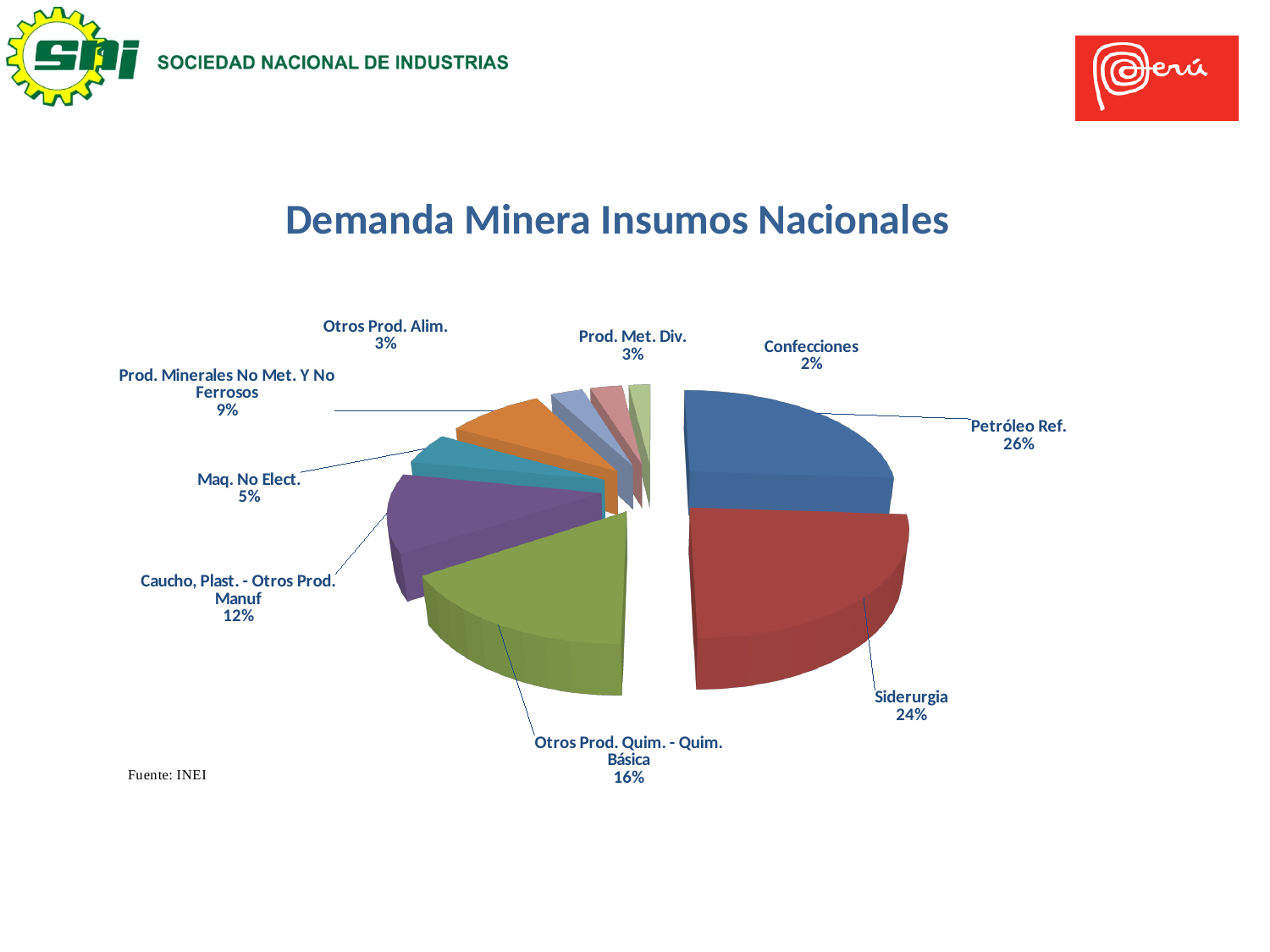
What kind of chart is shown on the slide? Pie chart What share of the pie does Petróleo Ref. represent? 26% Which category has the largest slice of the pie? Petróleo Ref. What is the value shown for Siderurgia? 24% Which category has the smallest slice of the pie? Confecciones What is the value shown for Prod. Minerales No Met. Y No Ferrosos? 9% How many slices does the pie chart have? 9 What source is cited for the chart data? INEI Which is larger, the share for Otros Prod. Quim. - Quim. Básica or the share for Maq. No Elect.? Otros Prod. Quim. - Quim. Básica What is the difference between the shares of Petróleo Ref. and Siderurgia? 2% What is the title of the chart? Demanda Minera Insumos Nacionales What is the value shown for Caucho, Plast. - Otros Prod. Manuf? 12%